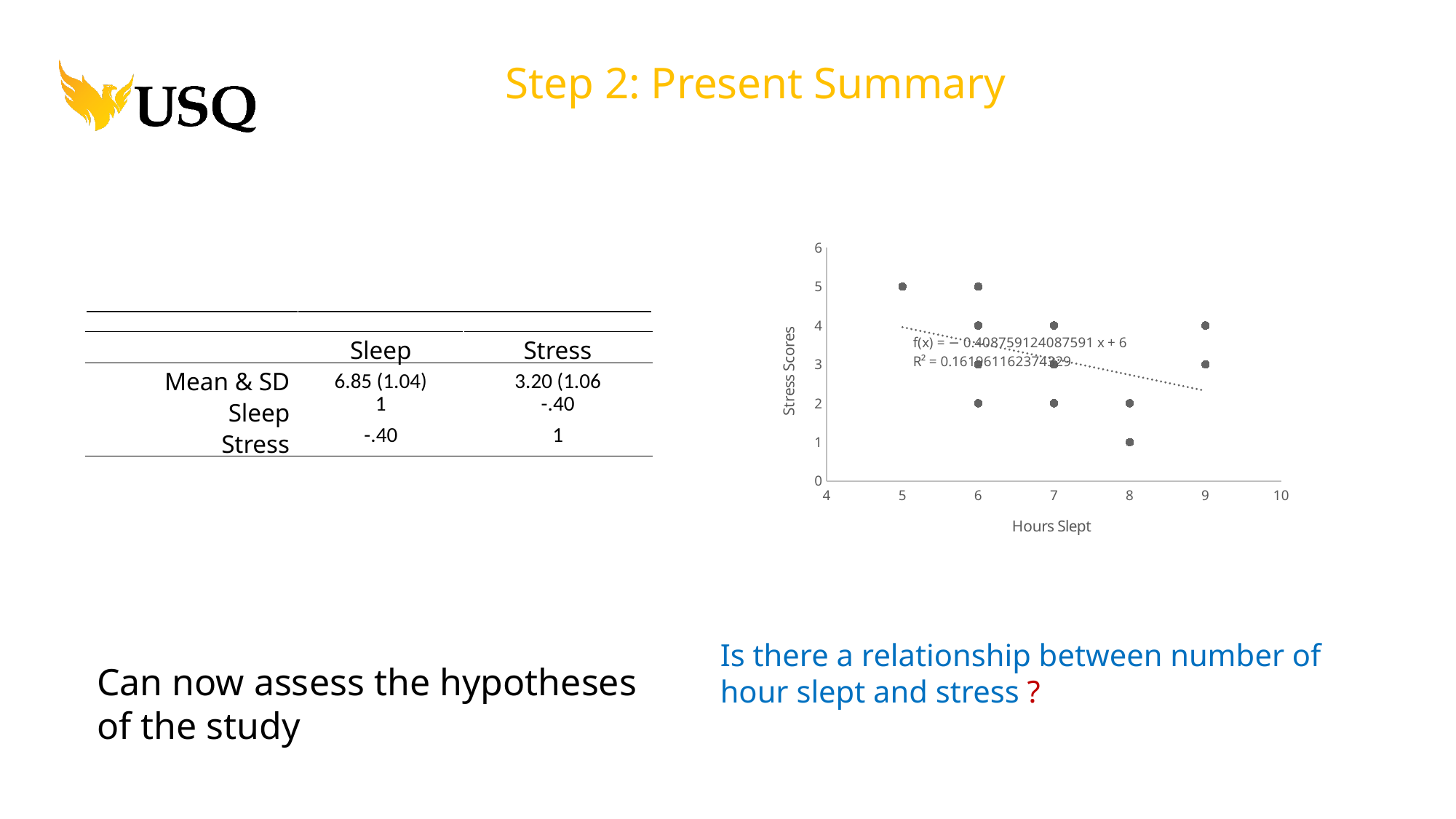
What kind of chart is shown on the slide? scatter chart At how many hours slept does the lowest stress score (1) occur? 8 What is the highest stress score plotted on the chart? 5 What is the lowest stress score plotted on the chart? 1 What is the intercept of the fitted line f(x) shown on the chart? 6 Do the stress scores tend to rise or fall as hours slept increases, according to the trend line? fall What is the largest number of hours slept among the plotted points? 9 What is the label of the x axis of the chart? Hours Slept What is the stress score of the point plotted at 5 hours slept? 5 What is the label of the y axis of the chart? Stress Scores